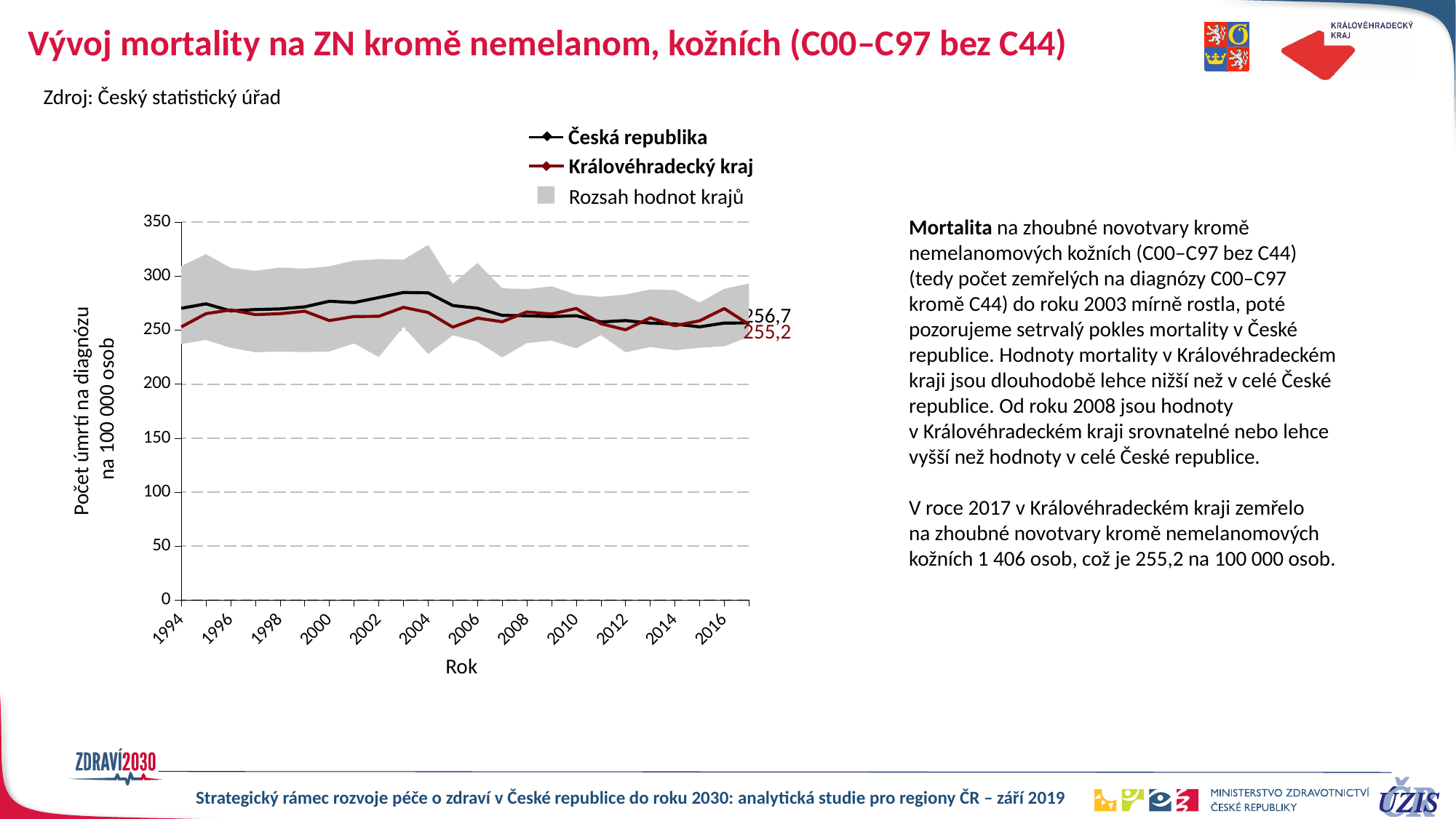
Is the value for Královéhradecký kraj in 1994 greater or less than 300? less Which series has the higher value in 2004: Česká republika or Královéhradecký kraj? Česká republika How many entries does the legend list? 3 What is the last labelled value for the Česká republika series? 256,7 Is the value for Česká republika in 2004 greater or less than 250? greater At the end of the series, which is larger: the labelled value for Česká republika or for Královéhradecký kraj? Česká republika What is the label of the y axis? Počet úmrtí na diagnózu na 100 000 osob What is the label of the x axis? Rok What kind of chart is shown on the slide? Line chart What is the difference between the final labelled values of Česká republika (256,7) and Královéhradecký kraj (255,2)? 1,5 Does the Česká republika line rise or fall from 2004 to the end of the series? fall What is the last labelled value for the Královéhradecký kraj series? 255,2